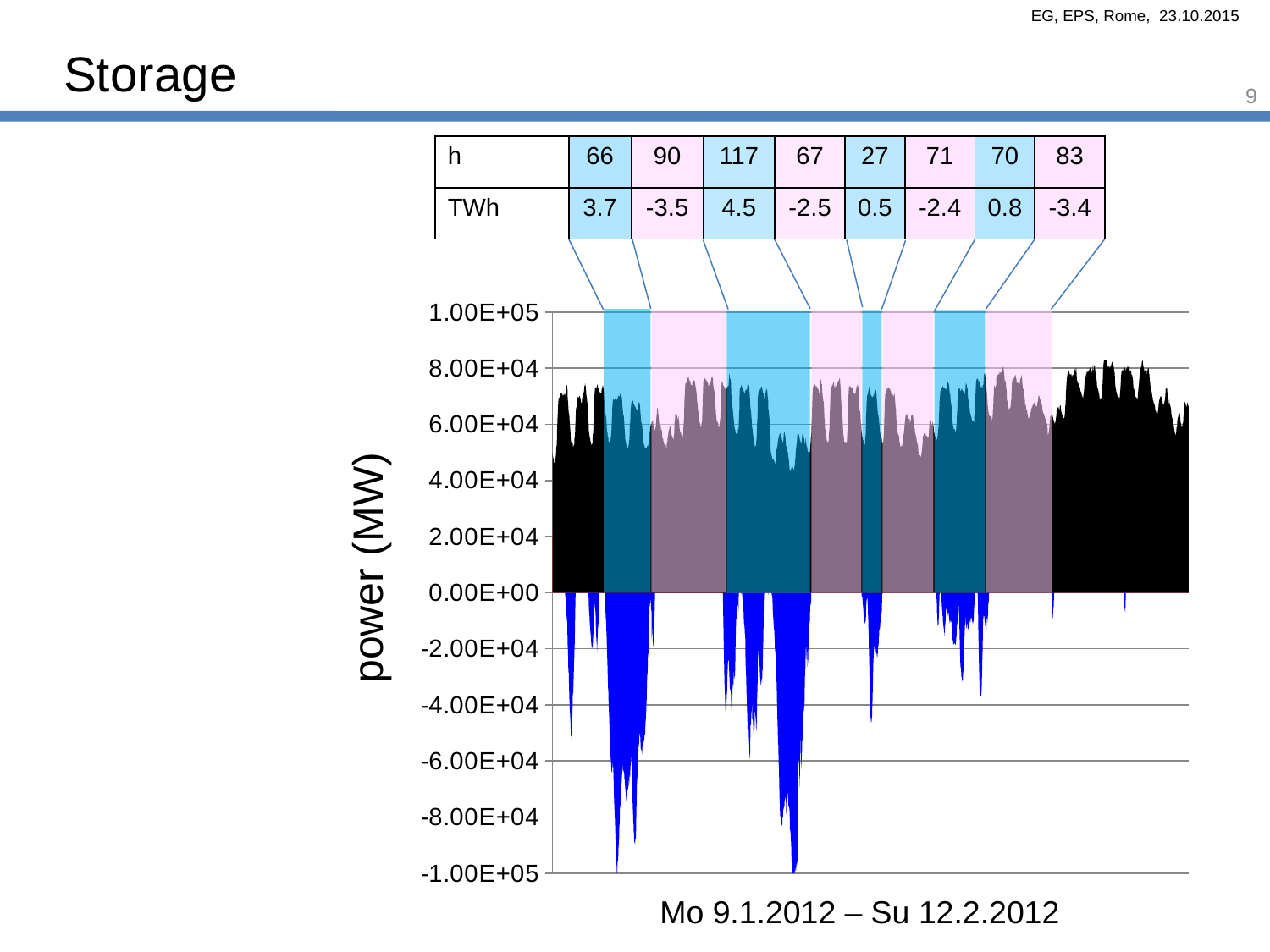
In the table above the chart, which period has the shortest duration in hours? 27 In the table above the chart, what is the TWh value for the first period (66 h)? 3.7 In the table above the chart, what is the difference in hours between the 117 h period and the 66 h period? 51 What time period does the x-axis of the chart cover? Mo 9.1.2012 – Su 12.2.2012 In the table above the chart, how many hours does the third period last? 117 What kind of chart is shown on the slide? area chart Is the lowest value reached by the blue negative area in the chart greater or less than -8.00E+04? less In the table above the chart, is the TWh value for the 70 h period larger or smaller than that for the 27 h period? larger What is the y-axis label of the chart? power (MW) How many storage periods are listed in the table above the chart? 8 In the table above the chart, which period has the lowest TWh value? 90 h period (-3.5 TWh) In the table above the chart, which period has the highest TWh value? 117 h period (4.5 TWh)